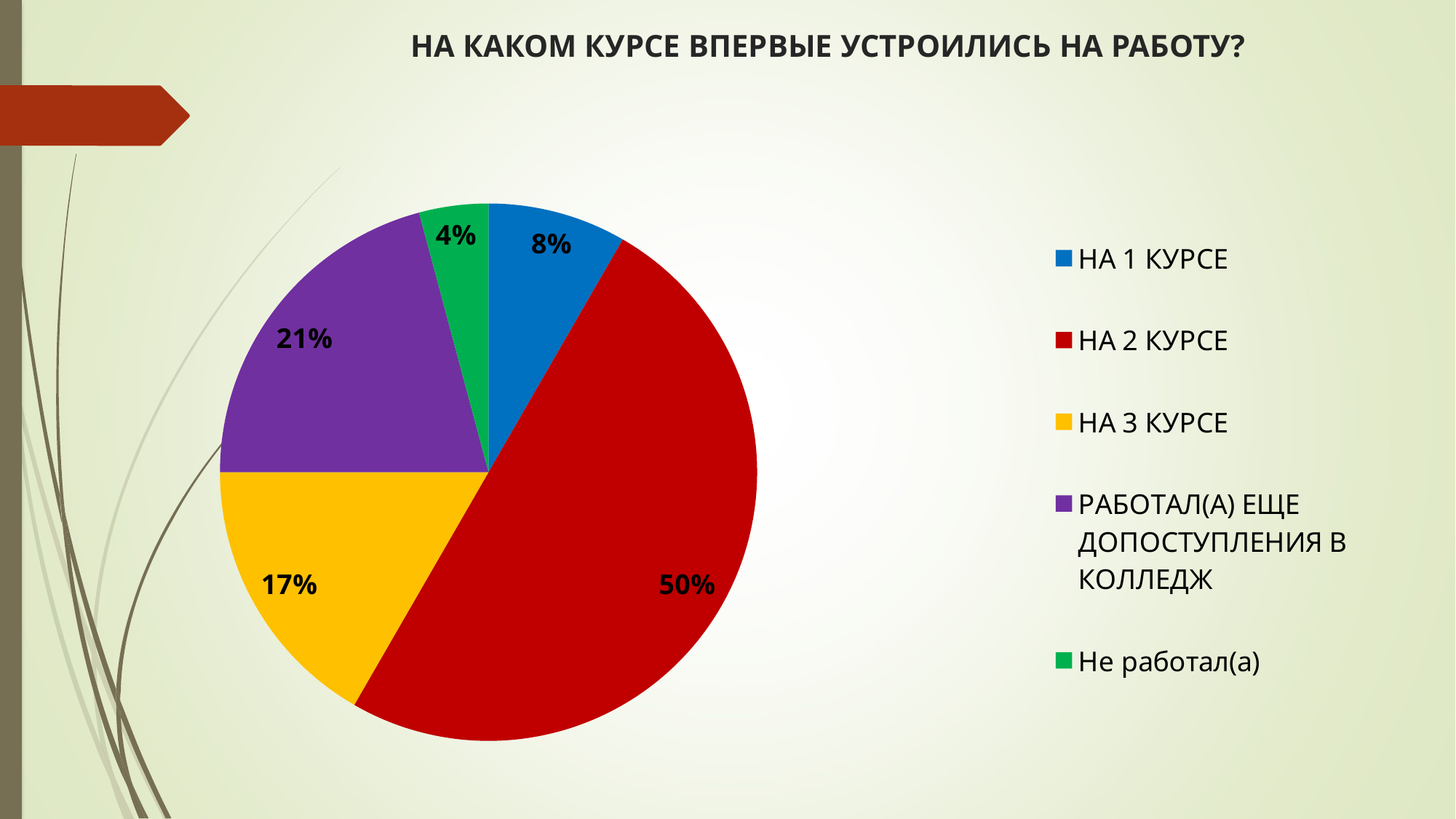
What is the title of the chart? НА КАКОМ КУРСЕ ВПЕРВЫЕ УСТРОИЛИСЬ НА РАБОТУ? Which category has the smallest slice of the pie? Не работал(а) What is the value shown for 'НА 1 КУРСЕ'? 8% What is the value shown for 'РАБОТАЛ(А) ЕЩЕ ДОПОСТУПЛЕНИЯ В КОЛЛЕДЖ'? 21% Which is larger, the value for 'НА 1 КУРСЕ' or the value for 'Не работал(а)'? НА 1 КУРСЕ What is the value shown for 'НА 3 КУРСЕ'? 17% What kind of chart is shown on the slide? Pie chart What share of the pie does the 'НА 2 КУРСЕ' slice represent? 50% What is the difference between the values for 'НА 2 КУРСЕ' and 'НА 3 КУРСЕ'? 33% Which category has the largest slice of the pie? НА 2 КУРСЕ What is the value shown for 'Не работал(а)'? 4% How many categories does the pie chart show? 5